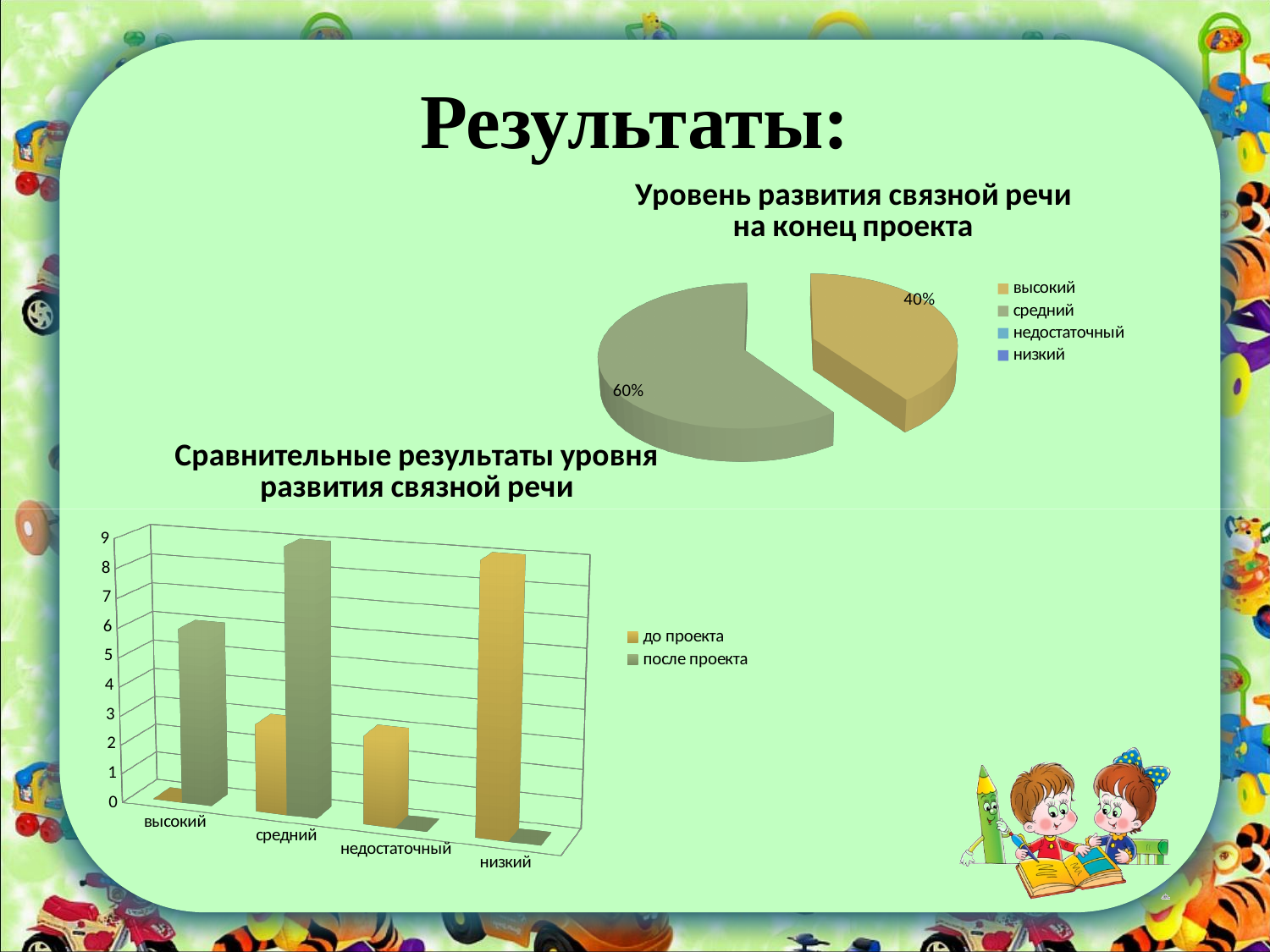
In the pie chart 'Уровень развития связной речи на конец проекта', what percentage is shown for the 'высокий' slice? 40% In the pie chart 'Уровень развития связной речи на конец проекта', what percentage is shown for the 'средний' slice? 60% In the pie chart 'Уровень развития связной речи на конец проекта', which category has the largest share? средний In the chart 'Сравнительные результаты уровня развития связной речи', is the value for 'средний' after the project (после проекта) greater or less than 7? greater In the pie chart 'Уровень развития связной речи на конец проекта', how many entries does the legend list? 4 What kind of chart is 'Сравнительные результаты уровня развития связной речи'? bar chart In the chart 'Сравнительные результаты уровня развития связной речи', is the value for 'низкий' before the project (до проекта) greater or less than 6? greater In the chart 'Сравнительные результаты уровня развития связной речи', how many series does the legend list? 2 In the pie chart 'Уровень развития связной речи на конец проекта', what is the difference in percentage points between the 'средний' and 'высокий' slices? 20 percentage points In the chart 'Сравнительные результаты уровня развития связной речи', is the value for 'недостаточный' before the project (до проекта) greater or less than 4? less In the chart 'Сравнительные результаты уровня развития связной речи', which is larger for the 'высокий' category: the value before the project (до проекта) or after the project (после проекта)? после проекта In the chart 'Сравнительные результаты уровня развития связной речи', how many categories are shown on the x axis? 4